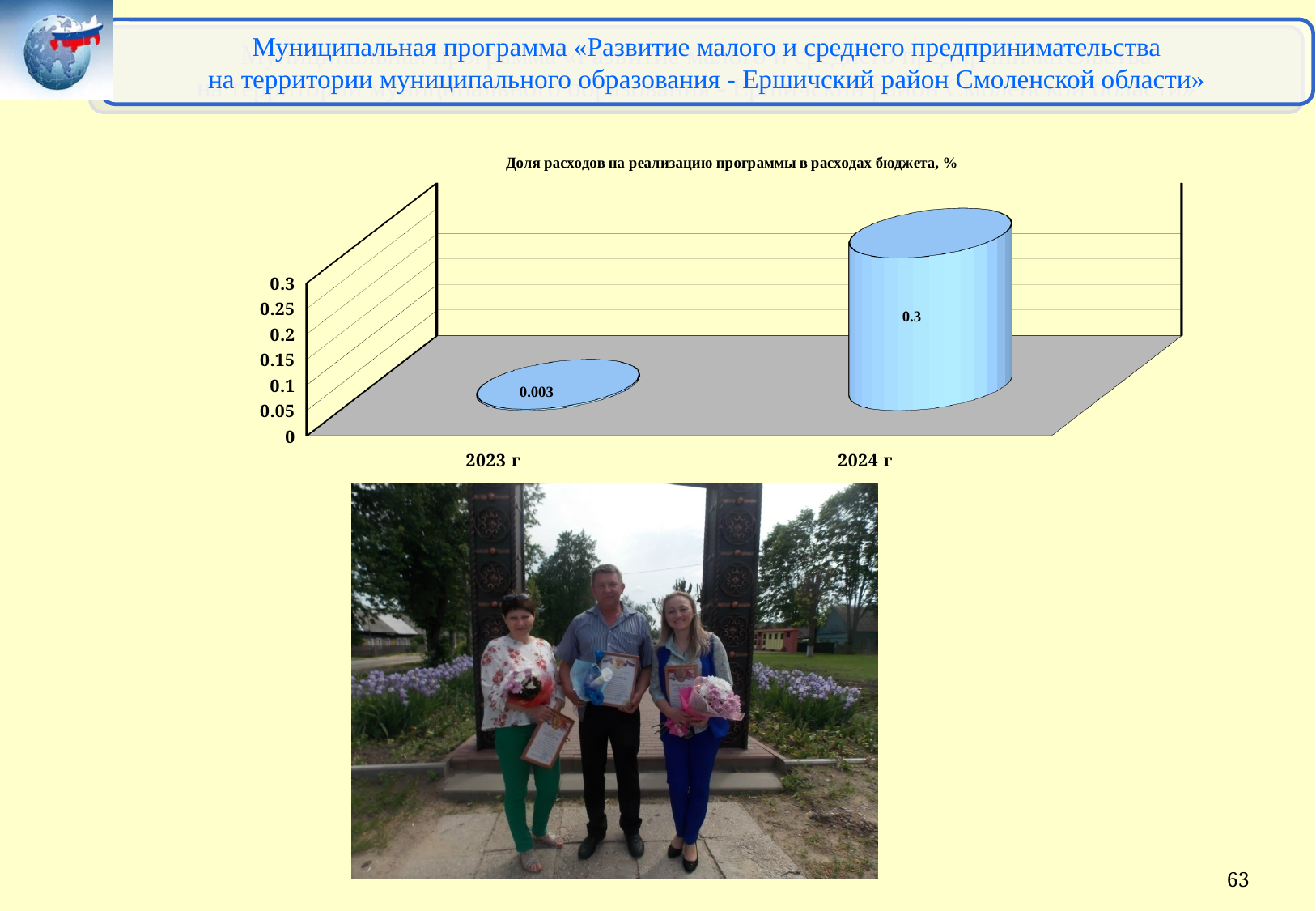
Is the value for 2023 г greater or less than 0.05? less How many categories are shown on the chart? 2 Is the value for 2024 г greater or less than 0.2? greater Which year has the lowest value? 2023 г What is the title of the chart? Доля расходов на реализацию программы в расходах бюджета, % Do the values rise or fall from 2023 г to 2024 г? Rise What is the value for 2024 г? 0.3 What kind of chart is shown on the slide? Bar chart What is the difference between the values for 2024 г and 2023 г? 0.297 Which is larger, the value for 2023 г or the value for 2024 г? 2024 г Which year has the highest value? 2024 г What is the value for 2023 г? 0.003